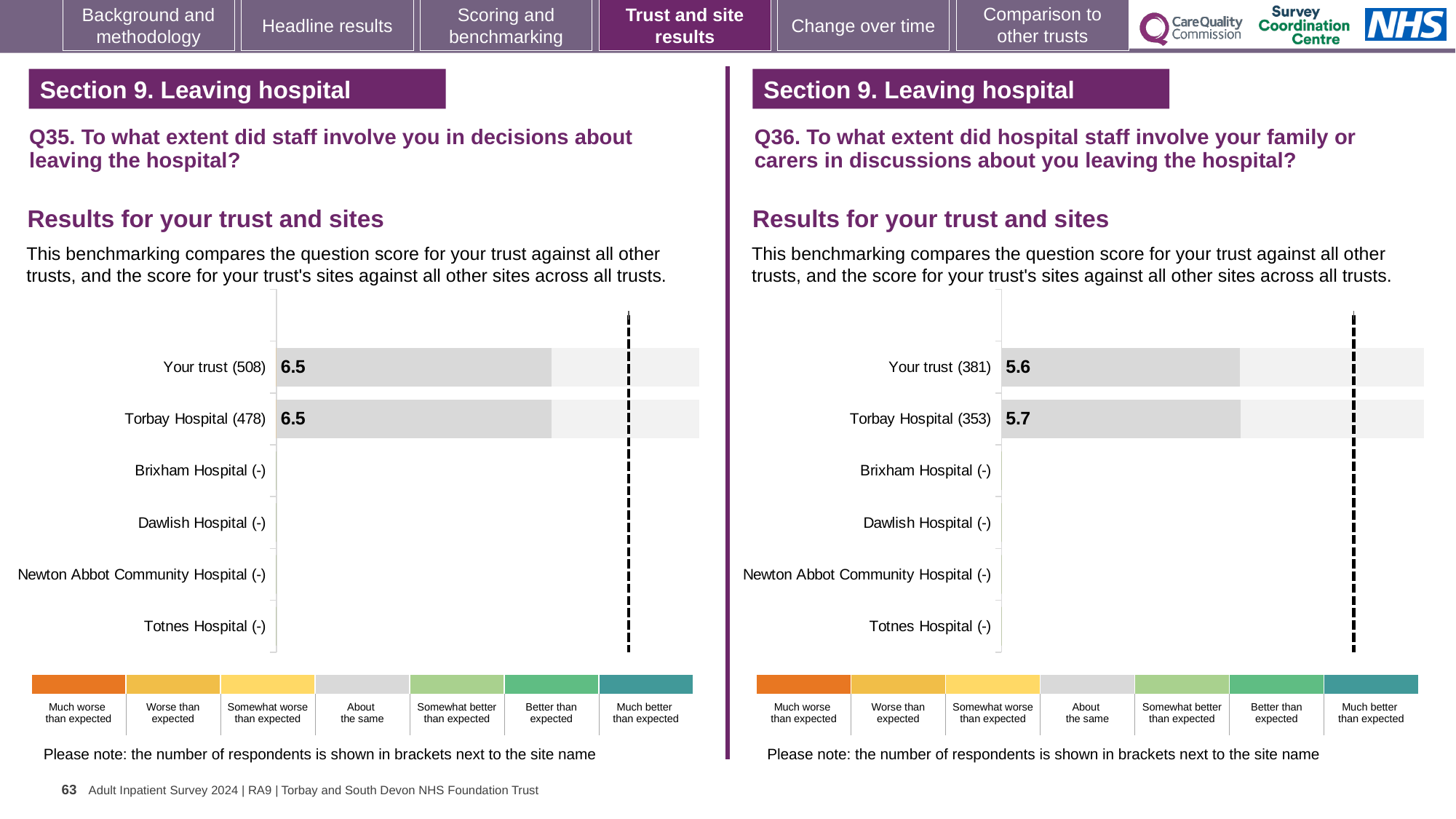
On the Q36 chart (right), how many categories have a plotted score bar? 2 Is the Your trust score on the Q35 chart (left) larger than the Your trust score on the Q36 chart (right)? Yes On the Q35 chart (left), how many site or trust categories are listed on the vertical axis? 6 On the Q36 chart (right), how many respondents are shown in brackets for Your trust? 381 On the Q36 chart (right), what is the score for Your trust (381)? 5.6 How many benchmark categories are shown in the colour key below each chart? 7 On the Q36 chart (right), what is the difference between the Torbay Hospital score and the Your trust score? 0.1 What type of chart is used on the Q35 chart (left)? Bar chart On the Q35 chart (left), how many respondents are shown in brackets for Torbay Hospital? 478 On the Q35 chart (left), what is the score for Your trust (508)? 6.5 On the Q35 chart (left), what is the score for Torbay Hospital (478)? 6.5 On the Q36 chart (right), what is the score for Torbay Hospital (353)? 5.7